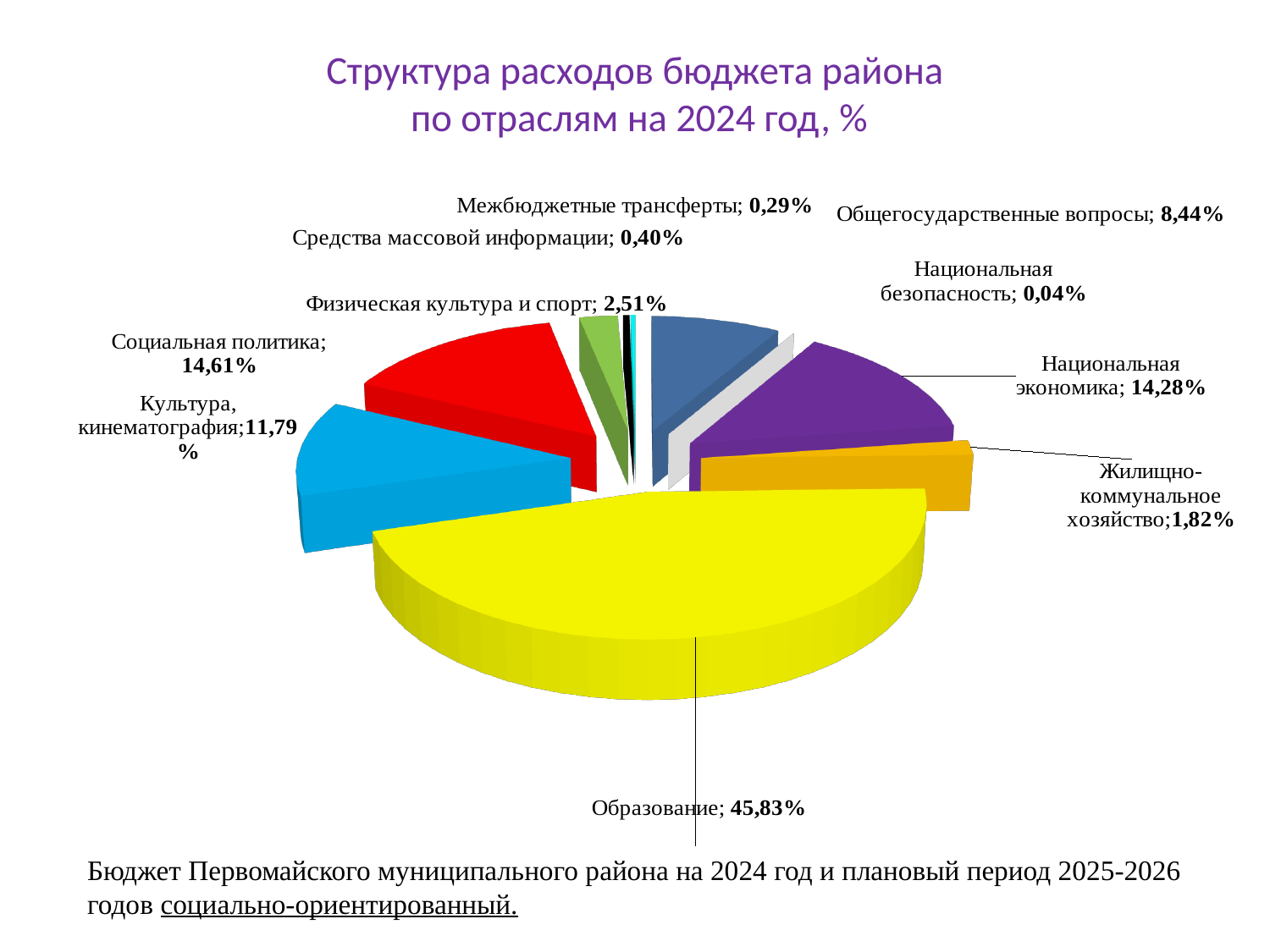
What is the difference between the shares of Социальная политика and Национальная экономика? 0,33% What is the share for Социальная политика? 14,61% Which is larger: Культура, кинематография or Общегосударственные вопросы? Культура, кинематография What is the share for Национальная экономика? 14,28% What is the share for Жилищно-коммунальное хозяйство? 1,82% What kind of chart is shown on the slide? Pie chart Which category has the largest share of the pie? Образование What is the title of the chart? Структура расходов бюджета района по отраслям на 2024 год, % Which category has the smallest share of the pie? Национальная безопасность What is the share for Образование? 45,83% How many categories are shown in the pie chart? 10 What is the share for Национальная безопасность? 0,04%